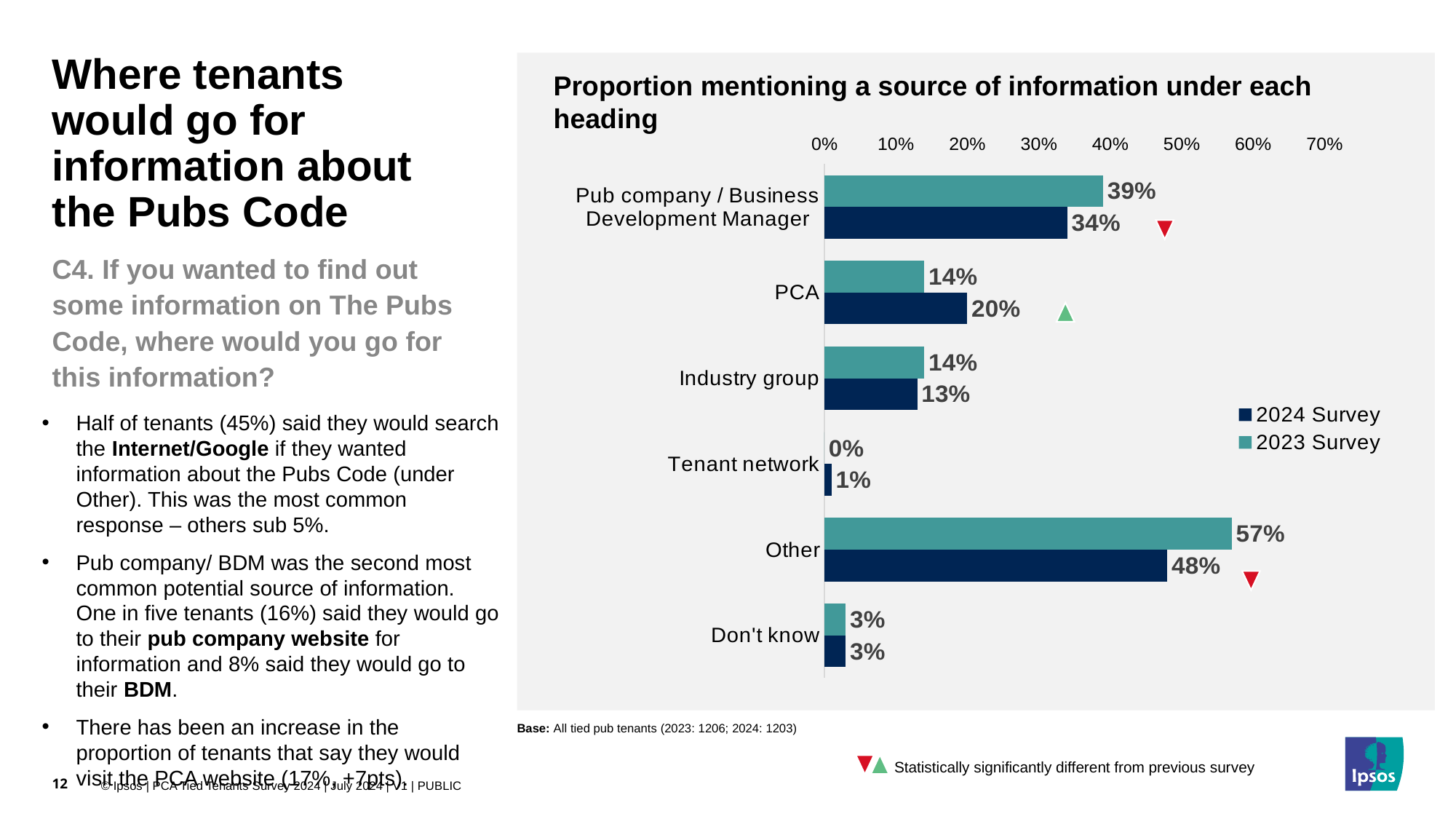
What is the 2024 Survey value for Other? 48% Which category has the lowest 2024 Survey value? Tenant network Which category has the highest 2023 Survey value? Other How many series does the legend list? 2 What is the difference between the 2023 Survey and 2024 Survey values for Other? 9% How many categories are shown on the chart? 6 What is the 2023 Survey value for Don't know? 3% What is the 2023 Survey value for Pub company / Business Development Manager? 39% What is the 2024 Survey value for PCA? 20% What is the title of the chart? Proportion mentioning a source of information under each heading What type of chart is shown on the slide? Bar chart Which is larger for PCA: the 2024 Survey value or the 2023 Survey value? 2024 Survey